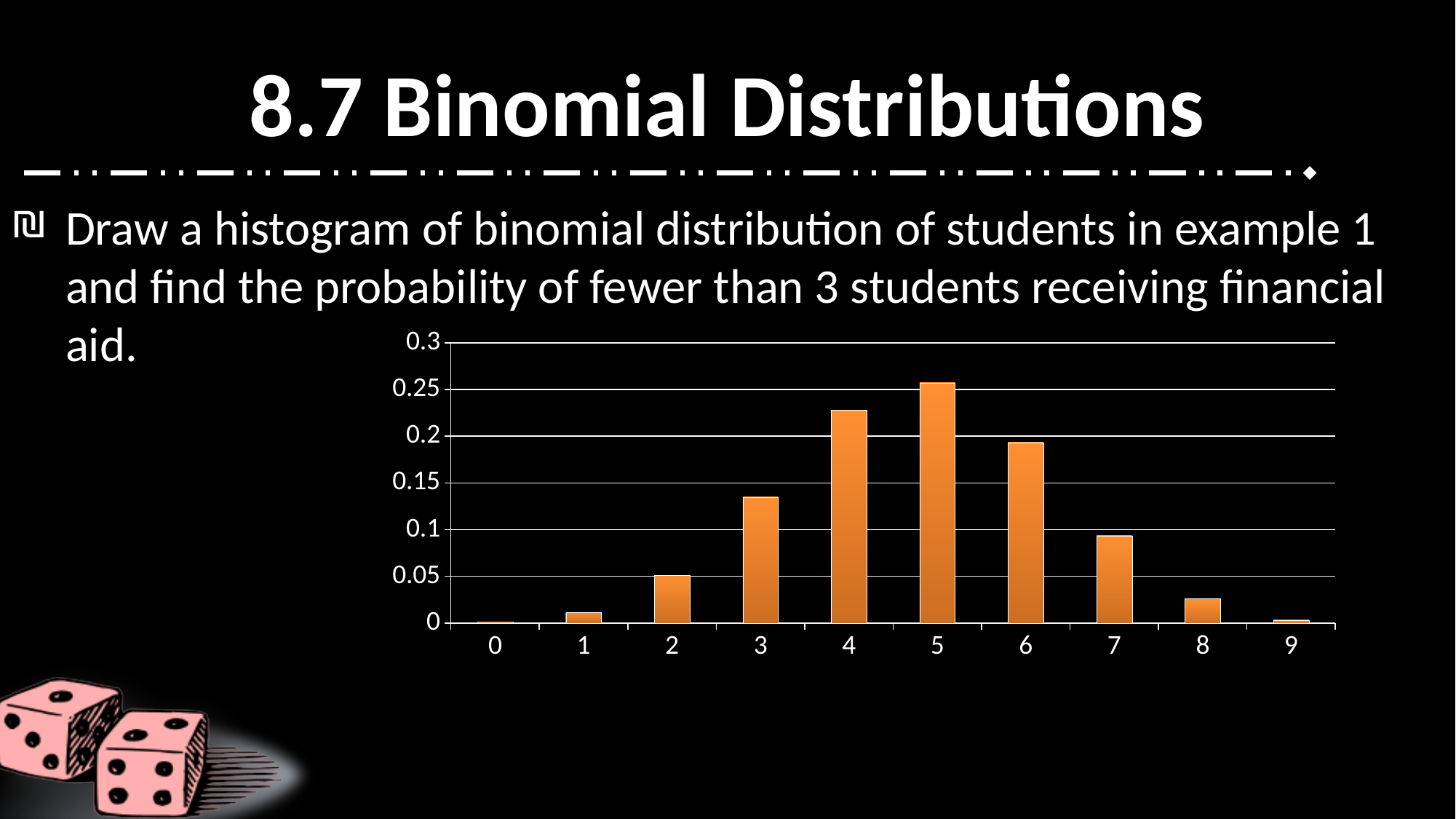
Which category has the lowest bar in the chart? 0 Is the value for category 7 greater or less than 0.1? less Which is larger, the value for category 3 or the value for category 7? 3 Is the value for category 4 greater or less than 0.2? greater What is the highest value shown on the y axis of the chart? 0.3 Is the value for category 8 greater or less than 0.05? less Which category has the highest bar in the chart? 5 What kind of chart is shown on the slide? bar chart Which is larger, the value for category 4 or the value for category 6? 4 How many categories are shown on the x axis of the chart? 10